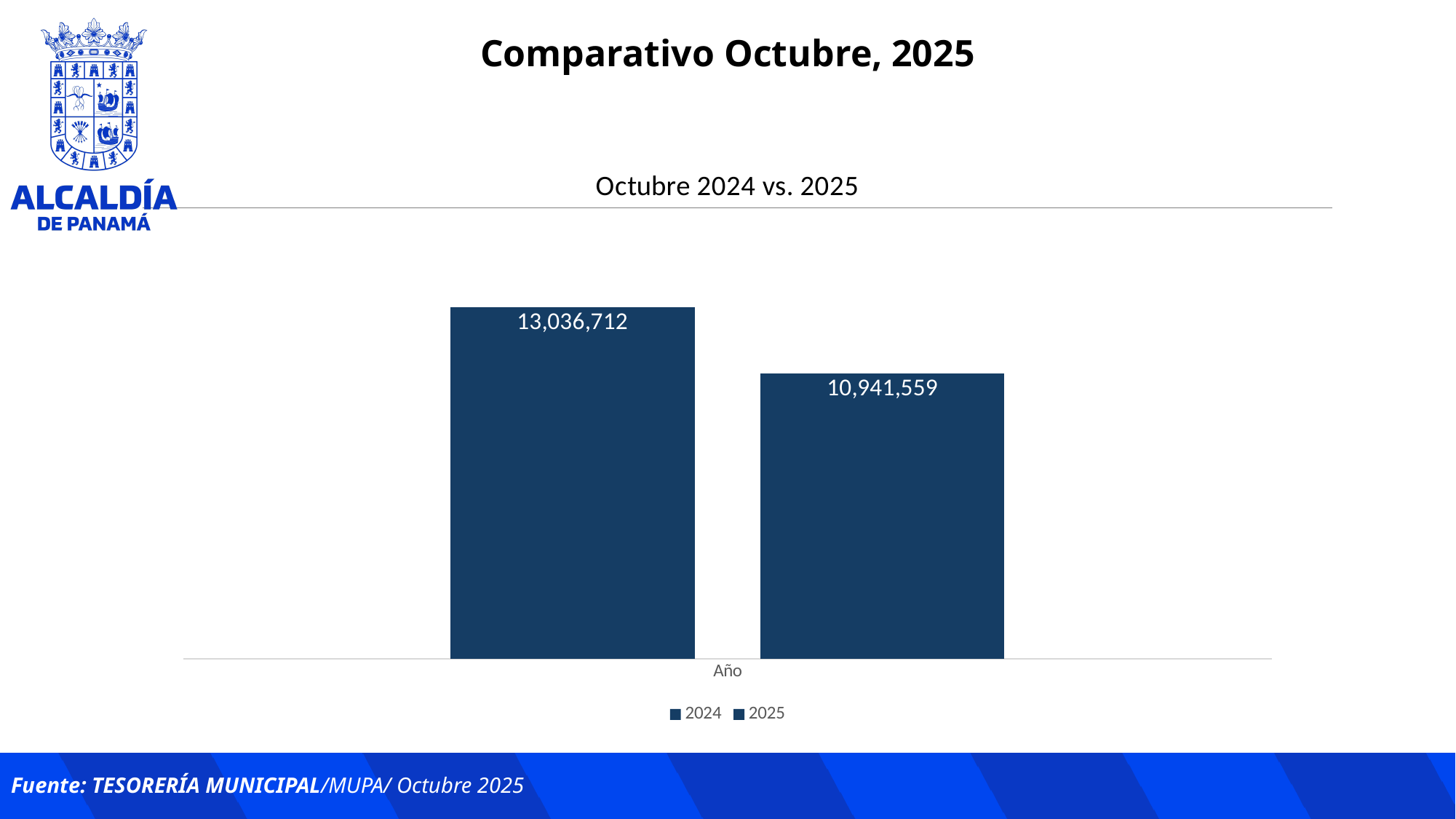
What is the label on the x axis of the chart? Año How many bars are plotted in the chart? 2 How many series does the legend list? 2 What kind of chart is shown on the slide? bar chart Which year has the higher value? 2024 Which year has the lower value? 2025 What is the value for 2025? 10,941,559 What is the title of the chart? Octubre 2024 vs. 2025 What is the value for 2024? 13,036,712 What is the difference between the 2024 value and the 2025 value? 2,095,153 Is the value for 2025 larger or smaller than the value for 2024? smaller Does the value rise or fall from 2024 to 2025? fall